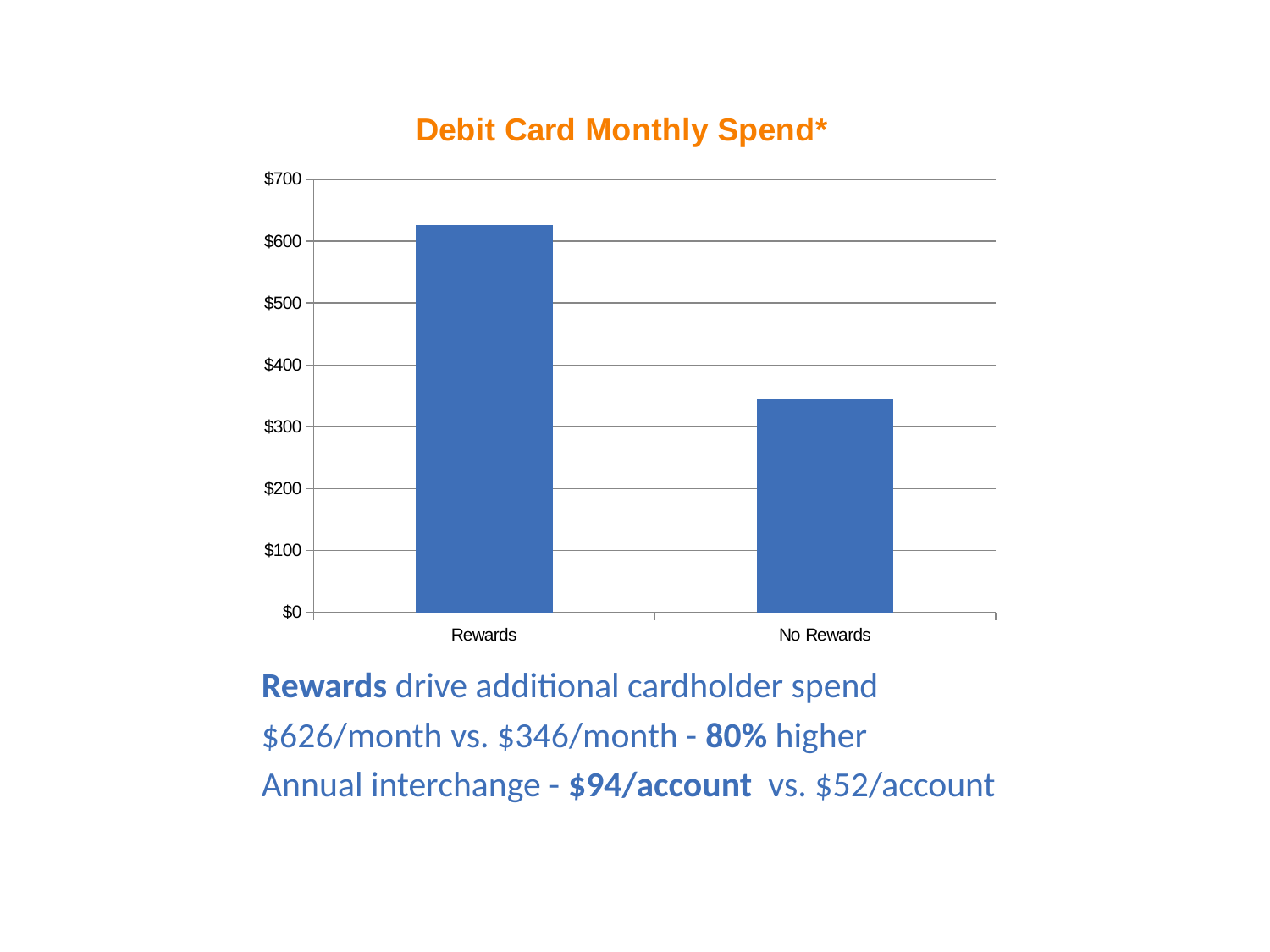
How many categories are shown on the x axis of the chart? 2 Is the monthly spend for No Rewards greater or less than $400? less According to the slide, what is the monthly spend for No Rewards cardholders? $346/month What is the maximum value shown on the y axis of the chart? $700 According to the slide, what is the monthly spend for Rewards cardholders? $626/month Which category has the lowest monthly spend? No Rewards Is the monthly spend for No Rewards greater or less than $300? greater What is the title of the chart? Debit Card Monthly Spend* Which is larger, the monthly spend for Rewards or for No Rewards? Rewards Is the monthly spend for Rewards greater or less than $600? greater Which category has the highest monthly spend? Rewards What type of chart is shown on the slide? bar chart